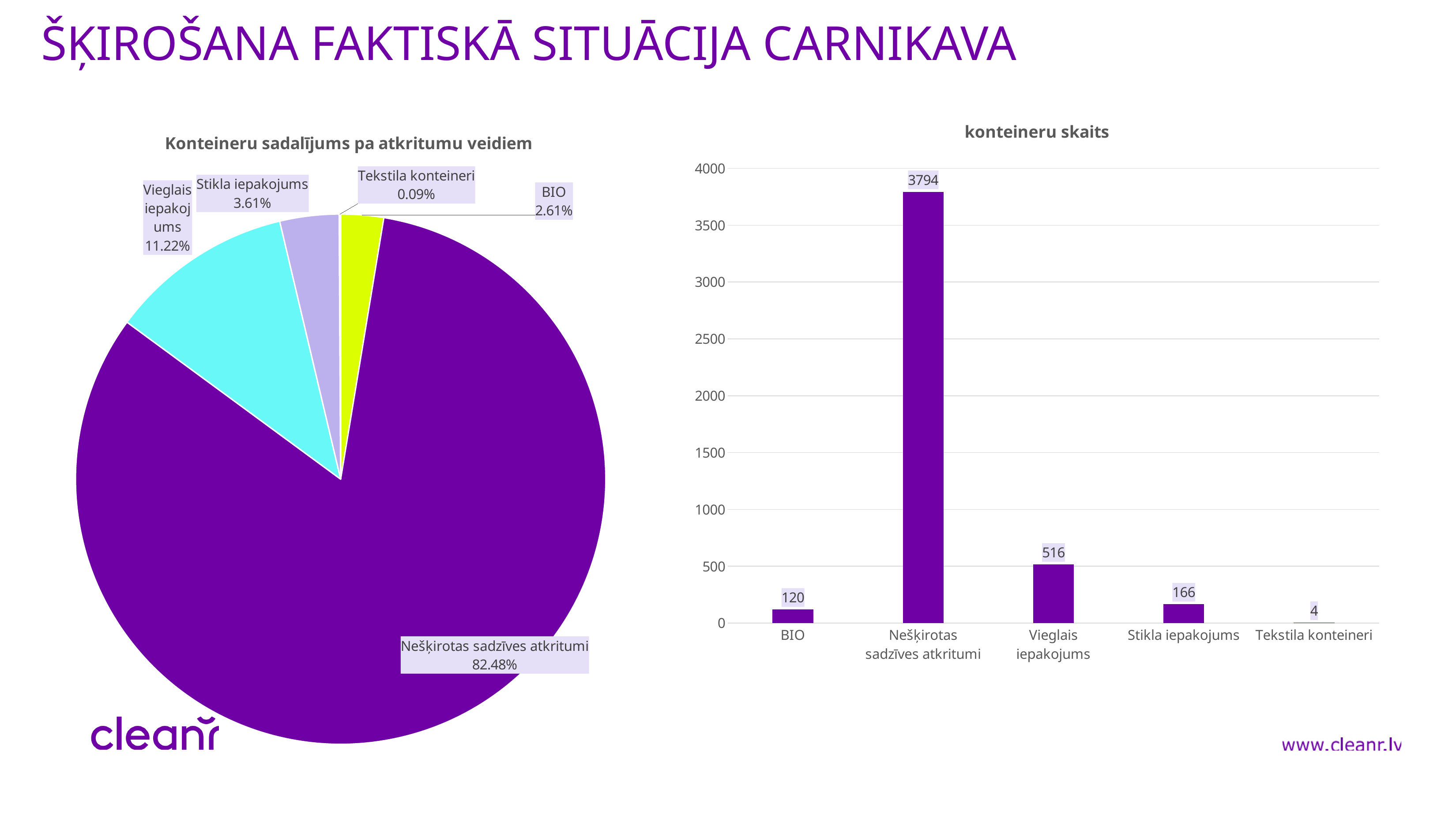
In the 'konteineru skaits' chart, what is the value for Tekstila konteineri? 4 In the 'konteineru skaits' chart, which is larger: BIO or Stikla iepakojums? Stikla iepakojums In the pie chart 'Konteineru sadalījums pa atkritumu veidiem', what share does BIO have? 2.61% In the 'konteineru skaits' chart, what is the value for Nešķirotas sadzīves atkritumi? 3794 What kind of chart is 'Konteineru sadalījums pa atkritumu veidiem'? pie chart In the 'konteineru skaits' chart, what is the difference between Vieglais iepakojums and Stikla iepakojums? 350 What kind of chart is 'konteineru skaits'? bar chart In the 'konteineru skaits' chart, what is the value for Vieglais iepakojums? 516 In the 'konteineru skaits' chart, which category has the lowest value? Tekstila konteineri How many categories are shown in the 'konteineru skaits' chart? 5 In the 'konteineru skaits' chart, which category has the highest value? Nešķirotas sadzīves atkritumi In the pie chart 'Konteineru sadalījums pa atkritumu veidiem', what share does Vieglais iepakojums have? 11.22%